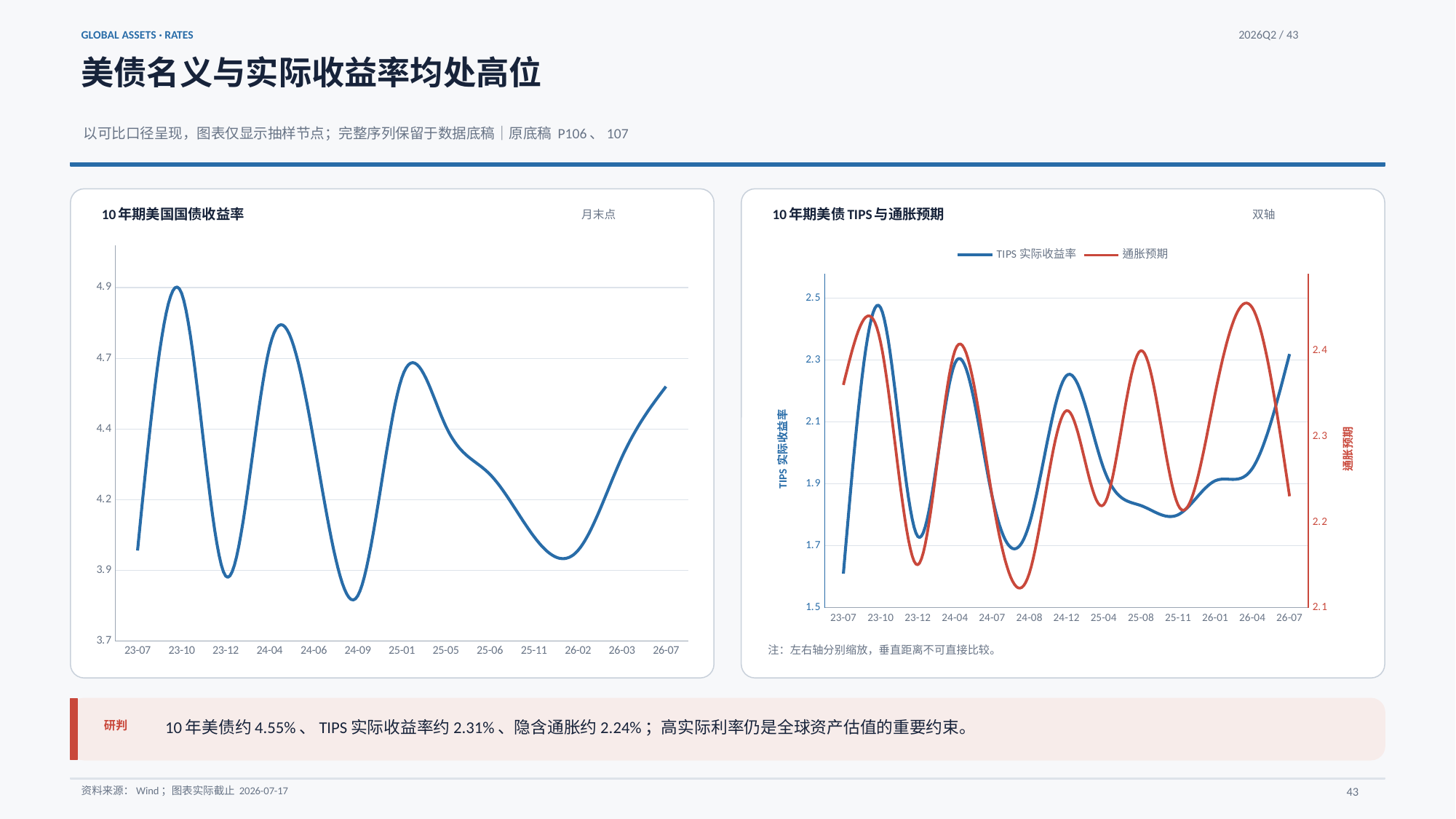
In the left chart (10年期美国国债收益率), which is higher, the value at 23-10 or the value at 24-04? 23-10 In the left chart (10年期美国国债收益率), is the value at 23-07 greater or less than 4.2? less In the left chart (10年期美国国债收益率), how many dates are labelled on the x axis? 13 In the left chart (10年期美国国债收益率), does the line rise or fall between 26-02 and 26-07? rise In the left chart (10年期美国国债收益率), is the value at 26-07 greater or less than 4.4? greater In the right chart (10年期美债 TIPS 与通胀预期), is the 通胀预期 value at 24-08 greater or less than 2.2 on the right axis? less In the left chart (10年期美国国债收益率), at which date is the yield highest? 23-10 What kind of chart is the left chart titled 10年期美国国债收益率? line chart In the left chart (10年期美国国债收益率), at which date is the yield lowest? 24-09 In the right chart (10年期美债 TIPS 与通胀预期), at which date is the TIPS 实际收益率 series highest? 23-10 How many series does the legend of the right chart (10年期美债 TIPS 与通胀预期) list? 2 In the right chart (10年期美债 TIPS 与通胀预期), which series is drawn in red? 通胀预期